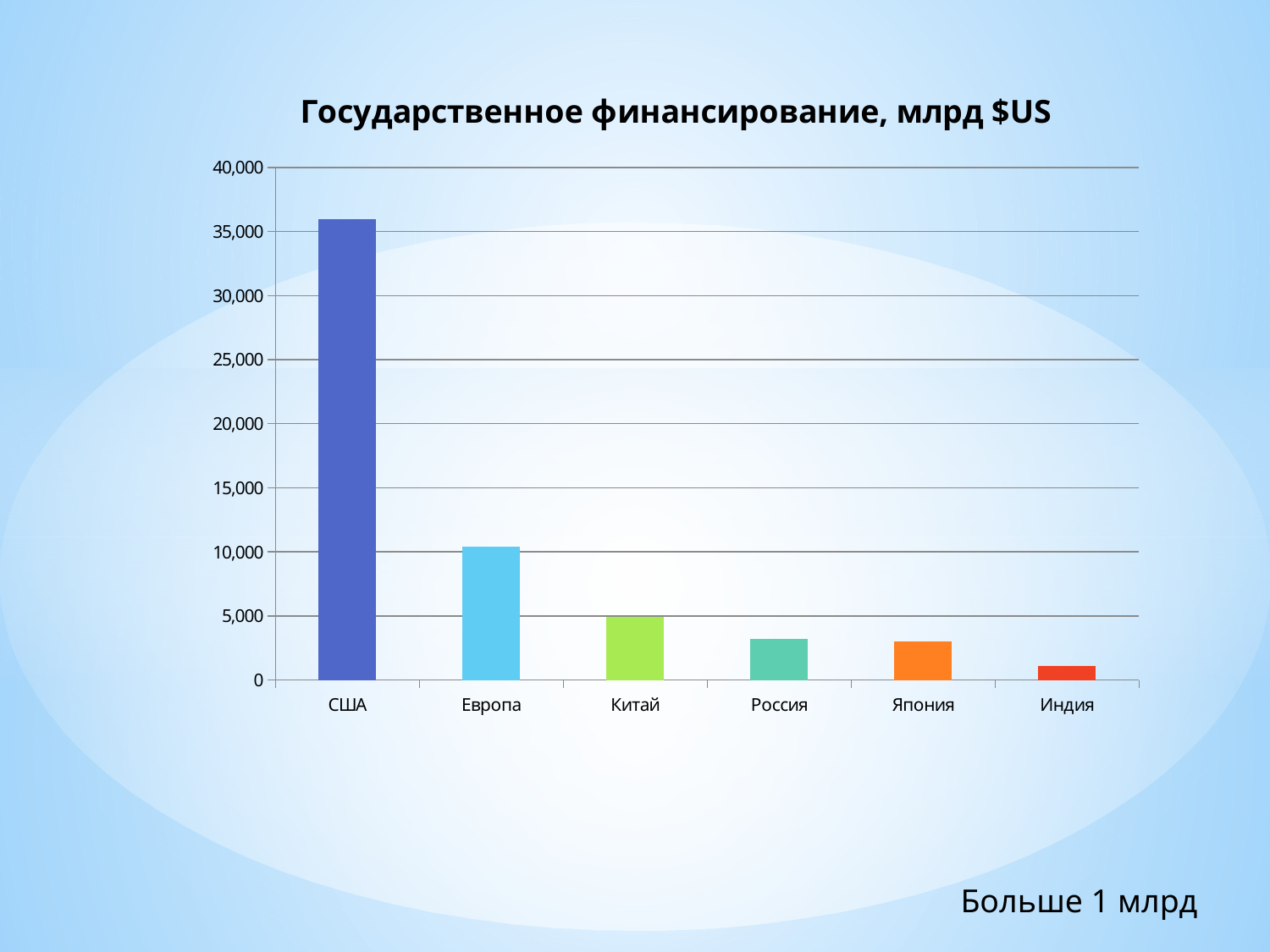
Which is larger, the value for Япония or the value for Индия? Япония What is the title of the chart? Государственное финансирование, млрд $US Which category has the highest value in the chart? США Is the value for Индия greater or less than 5,000? less Which category has the lowest value in the chart? Индия Is the value for США greater or less than 35,000? greater Which is larger, the value for Европа or the value for Китай? Европа How many categories are shown on the x axis of the chart? 6 Do the values rise or fall from left to right along the x axis? fall What kind of chart is shown on the slide? bar chart